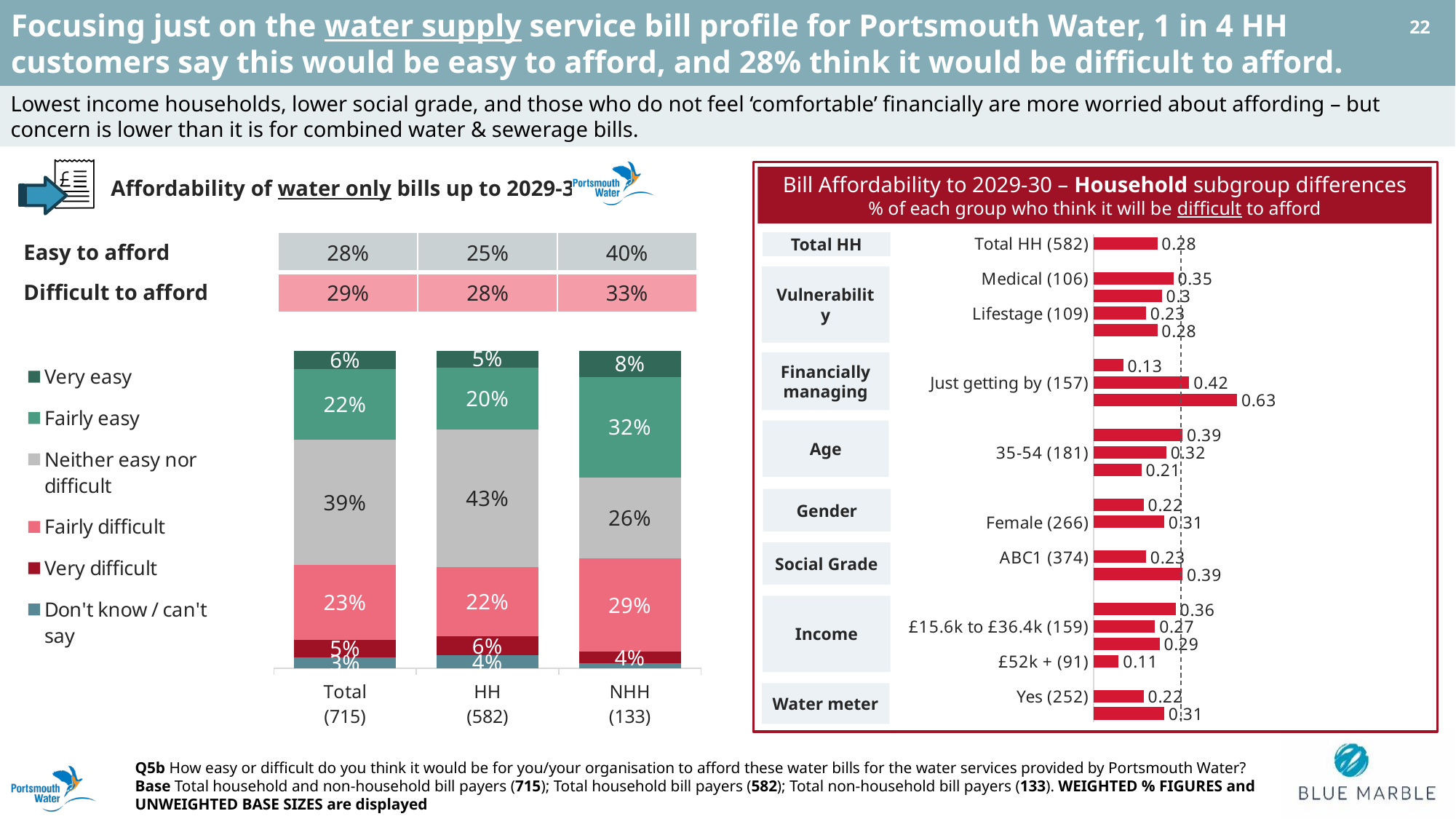
In the 'Bill Affordability to 2029-30 – Household subgroup differences' chart, which is larger, ABC1 (374) or Yes (252)? ABC1 (374) In the 'Bill Affordability to 2029-30 – Household subgroup differences' chart, what is the value for Just getting by (157)? 0.42 What type of chart is the 'Affordability of water only bills up to 2029-30' chart? Stacked bar chart In the 'Bill Affordability to 2029-30 – Household subgroup differences' chart, which labelled group has the lowest value? £52k + (91) In the 'Affordability of water only bills up to 2029-30' chart, what percentage of HH (582) said 'Very difficult'? 6% In the 'Affordability of water only bills up to 2029-30' chart, what percentage of the Total (715) group said 'Neither easy nor difficult'? 39% In the 'Affordability of water only bills up to 2029-30' chart, what is the difference between the 'Fairly difficult' share for NHH (133) and for HH (582)? 7% In the 'Affordability of water only bills up to 2029-30' chart, what percentage of NHH (133) said 'Fairly easy'? 32% In the 'Bill Affordability to 2029-30 – Household subgroup differences' chart, what is the value for Female (266)? 0.31 In the 'Affordability of water only bills up to 2029-30' chart, which group has the larger 'Neither easy nor difficult' share, HH (582) or NHH (133)? HH (582) In the 'Bill Affordability to 2029-30 – Household subgroup differences' chart, what is the difference between Medical (106) and Total HH (582)? 0.07 In the 'Affordability of water only bills up to 2029-30' chart, how many series does the legend list? 6